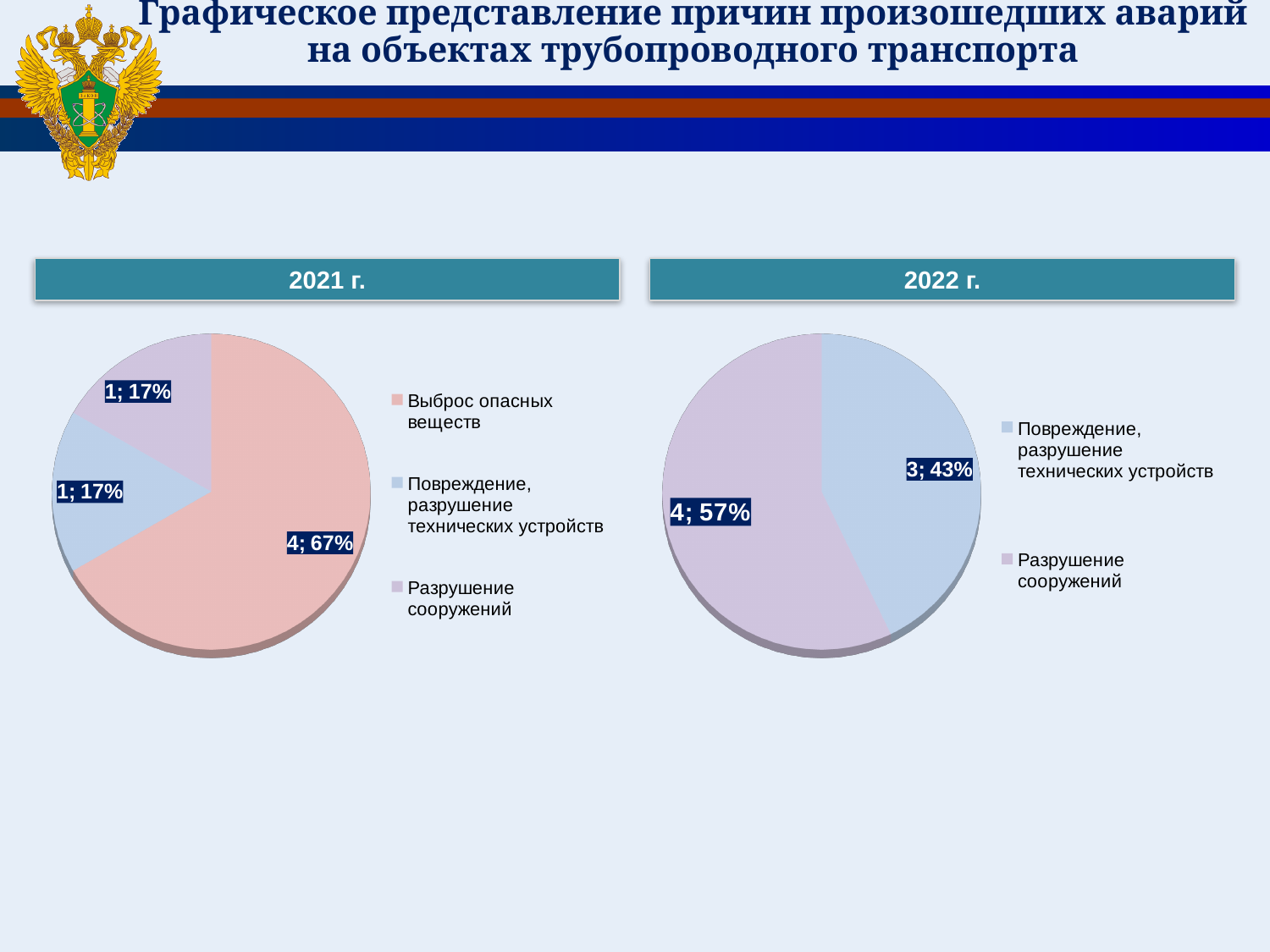
In the 2022 г. chart, what is the count value shown for Повреждение, разрушение технических устройств? 3 Which is larger: the count for Выброс опасных веществ in the 2021 г. chart or the count for Повреждение, разрушение технических устройств in the 2022 г. chart? Выброс опасных веществ in 2021 г. How many categories does the legend of the 2022 г. chart list? 2 How many categories does the legend of the 2021 г. chart list? 3 What type of chart is used for the 2021 г. chart? pie chart In the 2022 г. chart, what is the difference in count between Разрушение сооружений and Повреждение, разрушение технических устройств? 1 In the 2021 г. chart, what is the count value shown for Выброс опасных веществ? 4 In the 2022 г. chart, which category has the smallest slice? Повреждение, разрушение технических устройств In the 2021 г. chart, what share of the pie does Выброс опасных веществ take? 67% In the 2021 г. chart, what share of the pie does Разрушение сооружений take? 17% In the 2021 г. chart, which category has the largest slice? Выброс опасных веществ In the 2022 г. chart, what share of the pie does Разрушение сооружений take? 57%